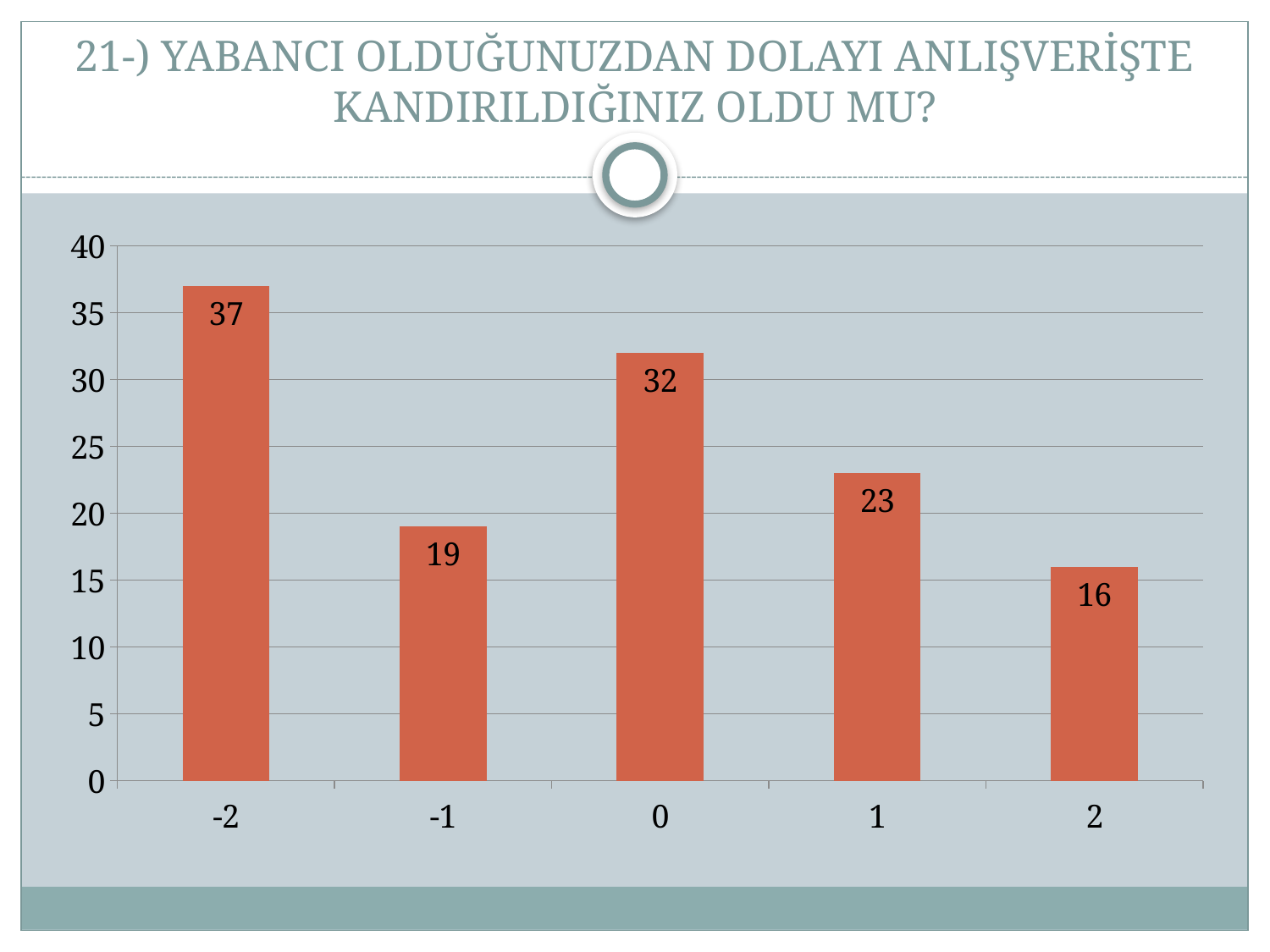
How many categories are shown on the x axis? 5 Which is larger, the value for -1 or the value for 1? 1 What is the value for category -2? 37 Which category has the lowest value? 2 What is the value for category 0? 32 What is the total of all five bar values? 127 Which category has the highest value? -2 What kind of chart is shown on the slide? bar chart What is the value for category 2? 16 What is the difference between the values for -2 and -1? 18 Is the value for category 1 greater or less than 20? greater What is the difference between the values for 0 and 1? 9